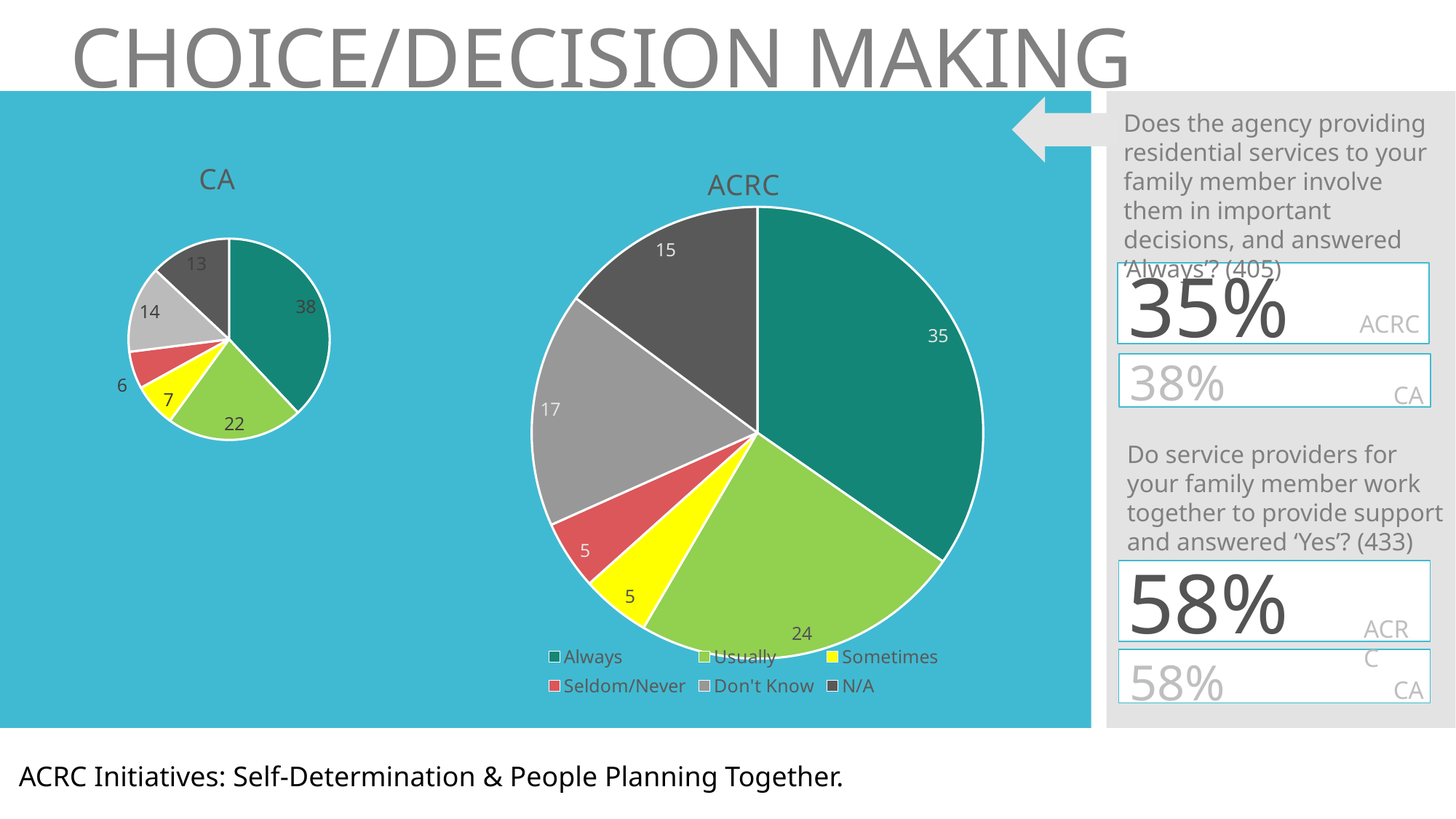
Which colour represents Sometimes in the legend? Yellow In the ACRC pie chart, what is the difference between the Usually and N/A values? 9 In the CA pie chart, which category has the largest slice? Always In the CA pie chart, which category has the smallest slice? Seldom/Never Which is larger: the Don't Know value in the CA pie chart or the Don't Know value in the ACRC pie chart? ACRC In the ACRC pie chart, what is the value for Don't Know? 17 In the CA pie chart, what is the value for Always? 38 In the ACRC pie chart, which category has the largest slice? Always How many slices does the ACRC pie chart have? 6 What is the difference between the Always values in the CA and ACRC pie charts? 3 In the ACRC pie chart, what is the value for Usually? 24 What type of chart is used for CA and ACRC? Pie chart